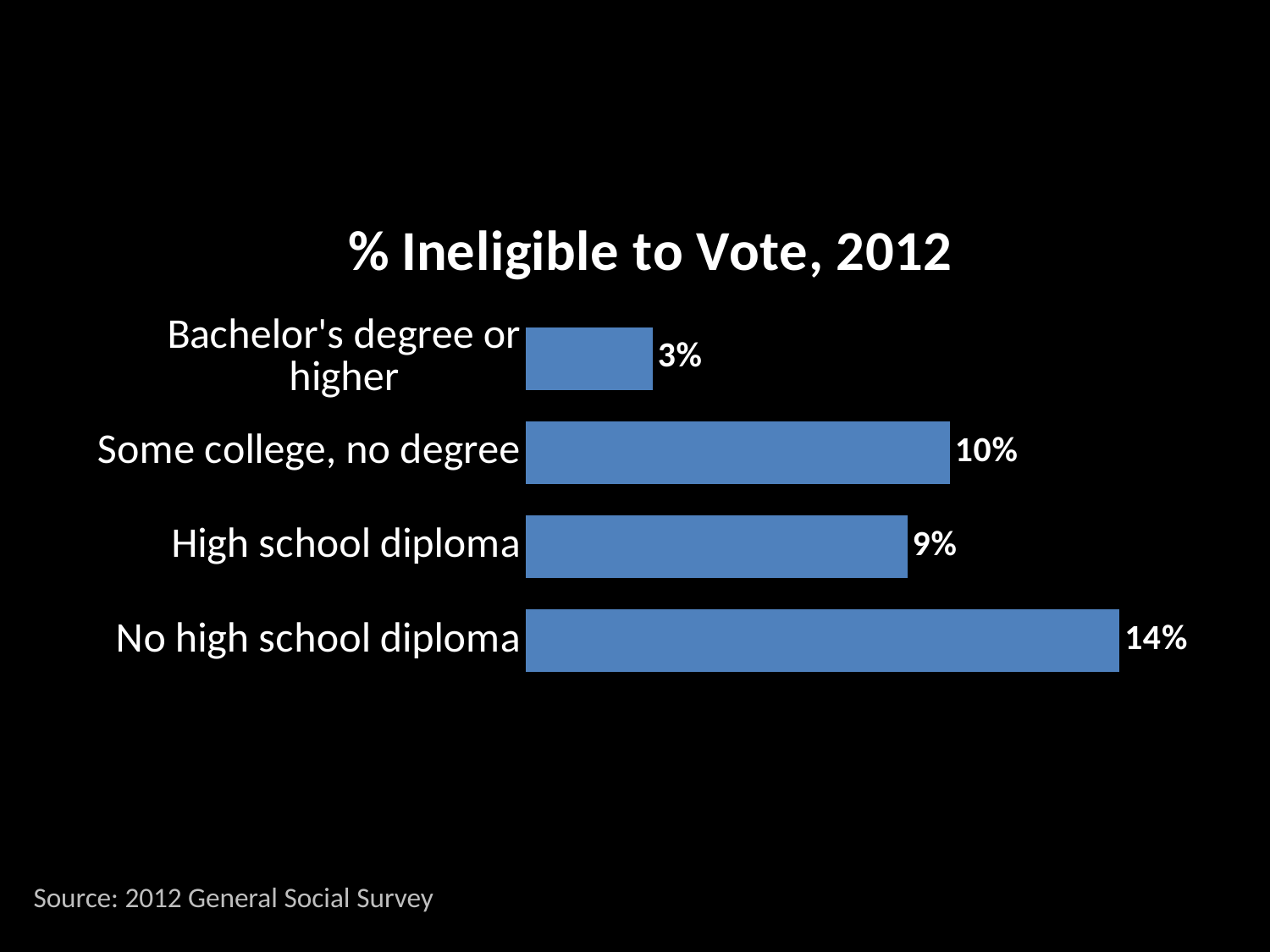
What is the difference between the values for No high school diploma and Bachelor's degree or higher? 11% Which category has the highest percentage ineligible to vote? No high school diploma What is the value for Some college, no degree? 10% What is the value for High school diploma? 9% Which is larger, the value for High school diploma or the value for Bachelor's degree or higher? High school diploma How many categories are shown in the chart? 4 What is the title of the chart? % Ineligible to Vote, 2012 What is the value for Bachelor's degree or higher? 3% What kind of chart is shown on the slide? Bar chart What is the difference between the values for Some college, no degree and High school diploma? 1% Which category has the lowest percentage ineligible to vote? Bachelor's degree or higher What is the value for No high school diploma? 14%